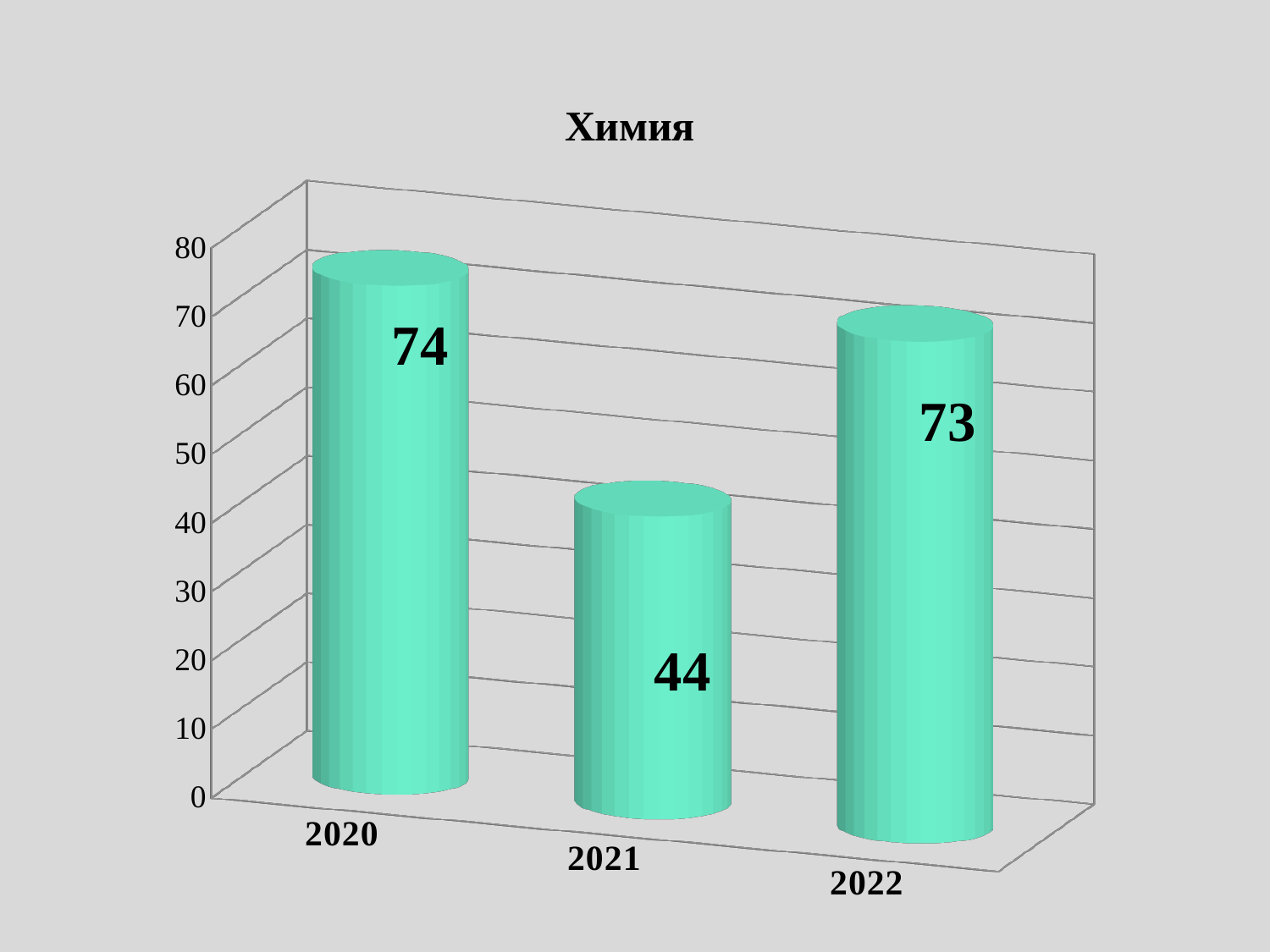
Which year has the highest value? 2020 What is the value for 2022? 73 What is the value for 2020? 74 Which year has the lowest value? 2021 What is the difference between the values for 2020 and 2021? 30 Which is larger, the value for 2021 or the value for 2022? 2022 What is the title of the chart? Химия How many years are shown on the chart? 3 Is the value for 2021 greater or less than 50? less What is the difference between the values for 2022 and 2021? 29 What kind of chart is this? bar chart What is the value for 2021? 44